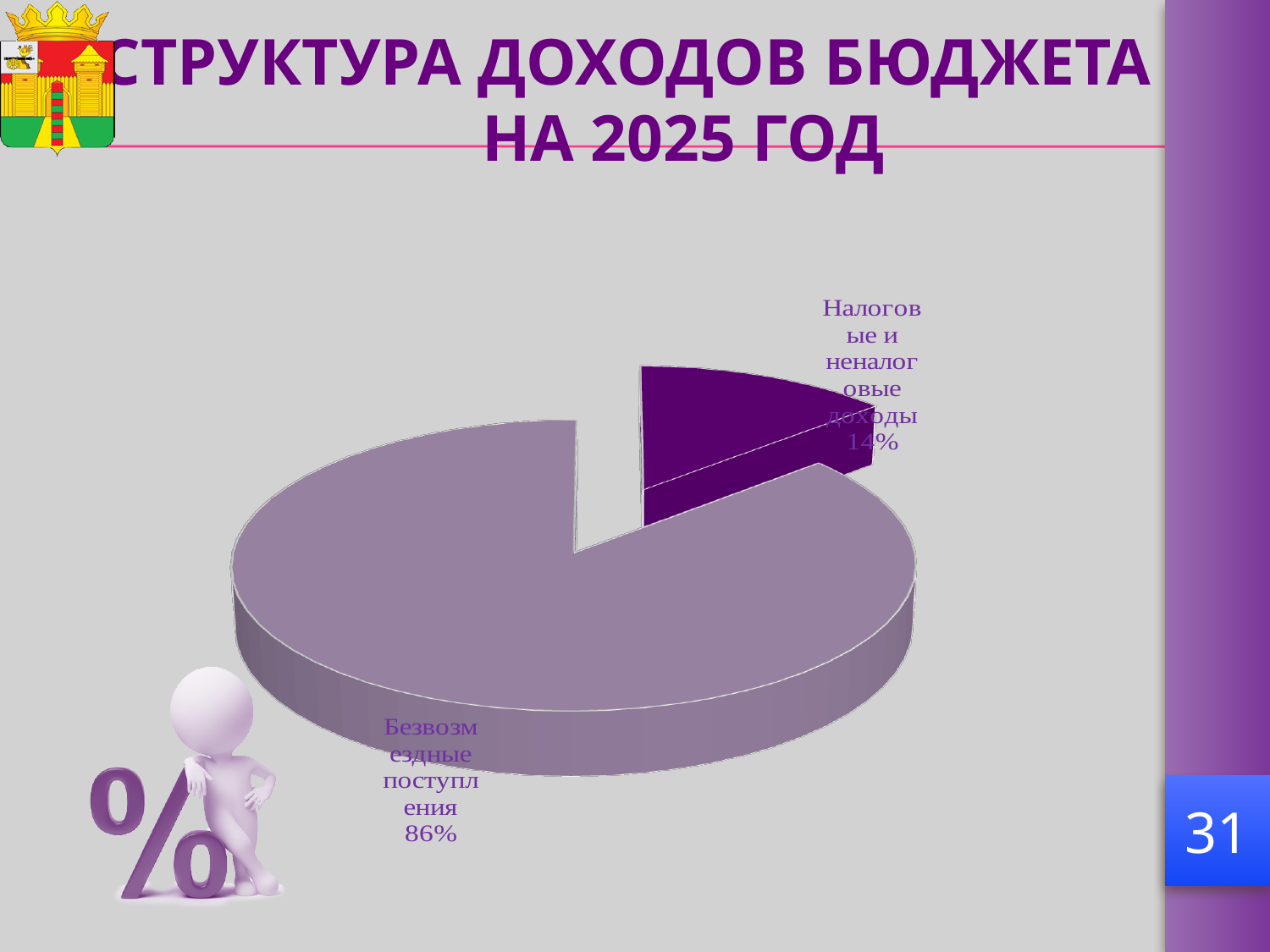
What is the title of the slide containing the pie chart? СТРУКТУРА ДОХОДОВ БЮДЖЕТА НА 2025 ГОД What kind of chart is shown on the slide? Pie chart Which slice of the pie chart is the largest? Безвозмездные поступления What share of the pie is labelled "Налоговые и неналоговые доходы"? 14% Which slice of the pie chart is the smallest? Налоговые и неналоговые доходы What is the total of the two percentages shown on the pie chart? 100% What share of the pie is labelled "Безвозмездные поступления"? 86% How many slices does the pie chart have? 2 Which is larger: the share for "Безвозмездные поступления" or the share for "Налоговые и неналоговые доходы"? Безвозмездные поступления Which slice is pulled out (exploded) from the pie chart? Налоговые и неналоговые доходы What is the difference in percentage points between "Безвозмездные поступления" and "Налоговые и неналоговые доходы"? 72 percentage points